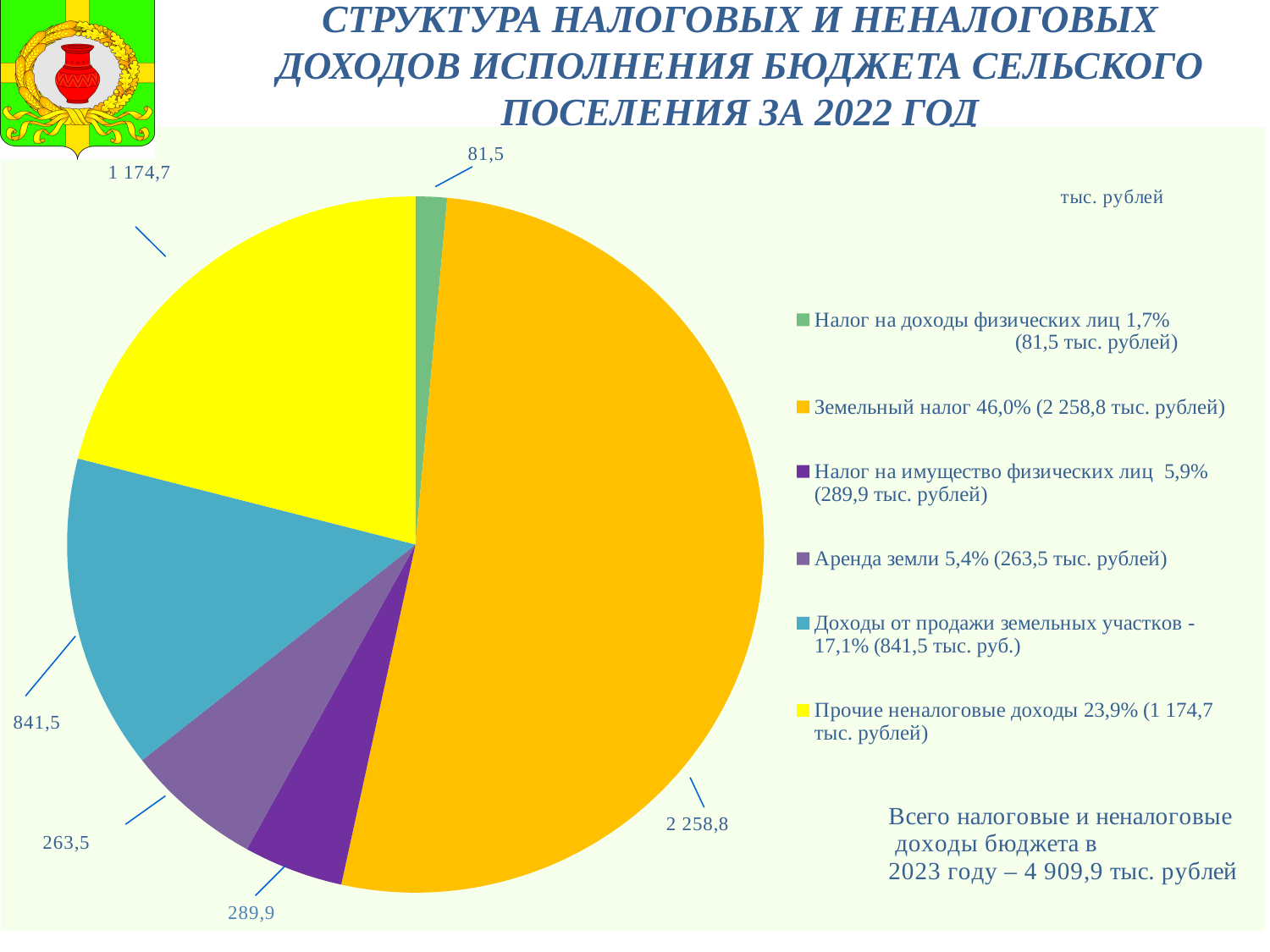
How many entries does the legend list? 6 What is the value shown for Доходы от продажи земельных участков? 841,5 What is the value shown for Налог на доходы физических лиц? 81,5 How many slices does the pie chart have? 6 What is the difference between the values for Налог на имущество физических лиц and Аренда земли? 26,4 What kind of chart is shown on the slide? pie chart Which is larger, the value for Прочие неналоговые доходы or the value for Доходы от продажи земельных участков? Прочие неналоговые доходы Which category has the smallest slice of the pie? Налог на доходы физических лиц Which category has the largest slice of the pie? Земельный налог What share of the pie does Прочие неналоговые доходы represent? 23,9% What share of the pie does Аренда земли represent? 5,4% What is the value shown for Земельный налог? 2 258,8